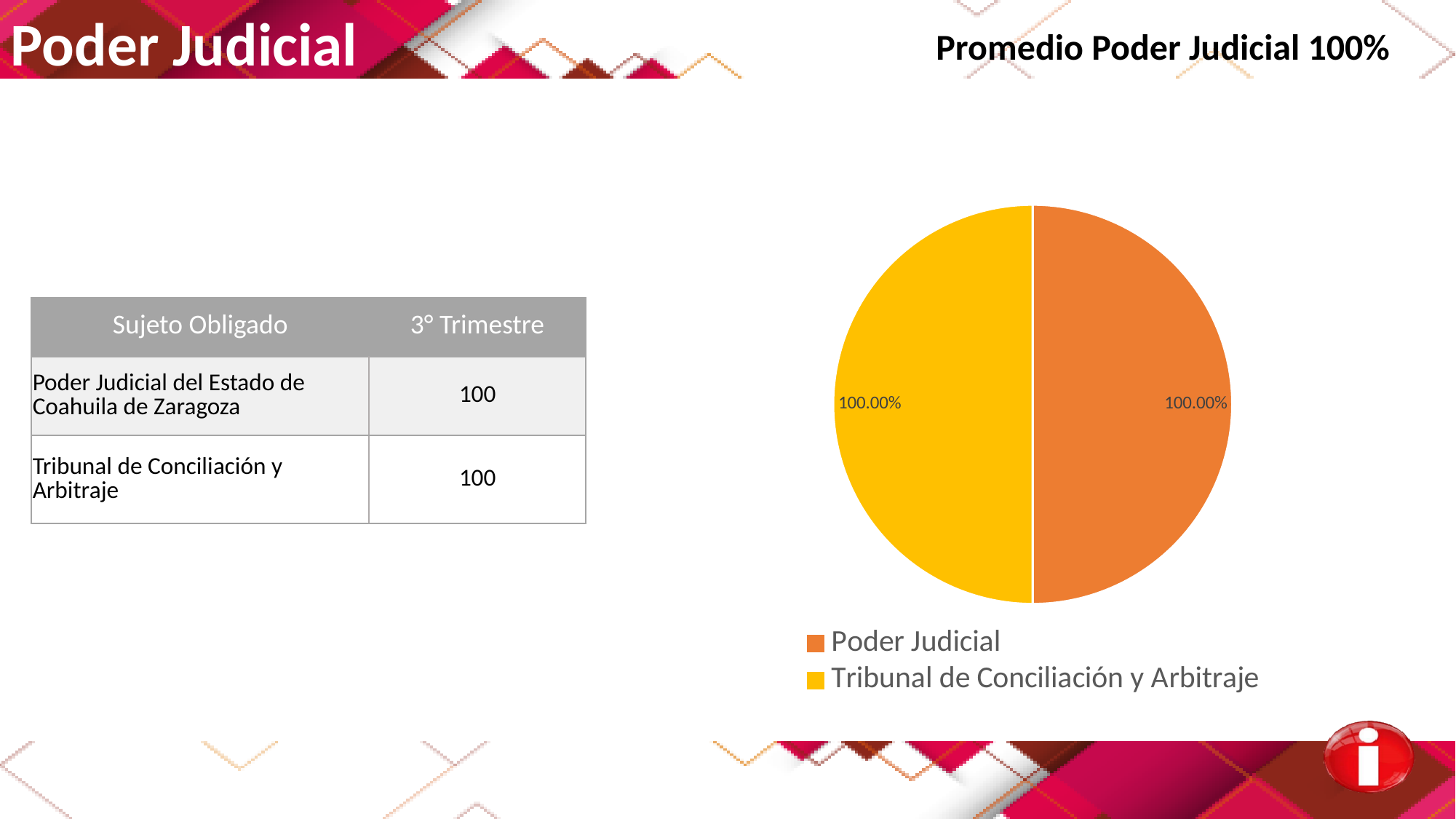
Which legend entry is listed first in the pie chart's legend? Poder Judicial How many slices does the pie chart have? 2 What is the data label shown on the Tribunal de Conciliación y Arbitraje slice of the pie chart? 100.00% How many entries does the legend of the pie chart list? 2 Is the data label on the Tribunal de Conciliación y Arbitraje slice greater or less than 50%? greater What colour is the Tribunal de Conciliación y Arbitraje slice in the pie chart? yellow What is the data label shown on the Poder Judicial slice of the pie chart? 100.00% What colour is the Poder Judicial slice in the pie chart? orange What kind of chart is shown on the slide? pie chart Is the data label on the Poder Judicial slice greater or less than 50%? greater